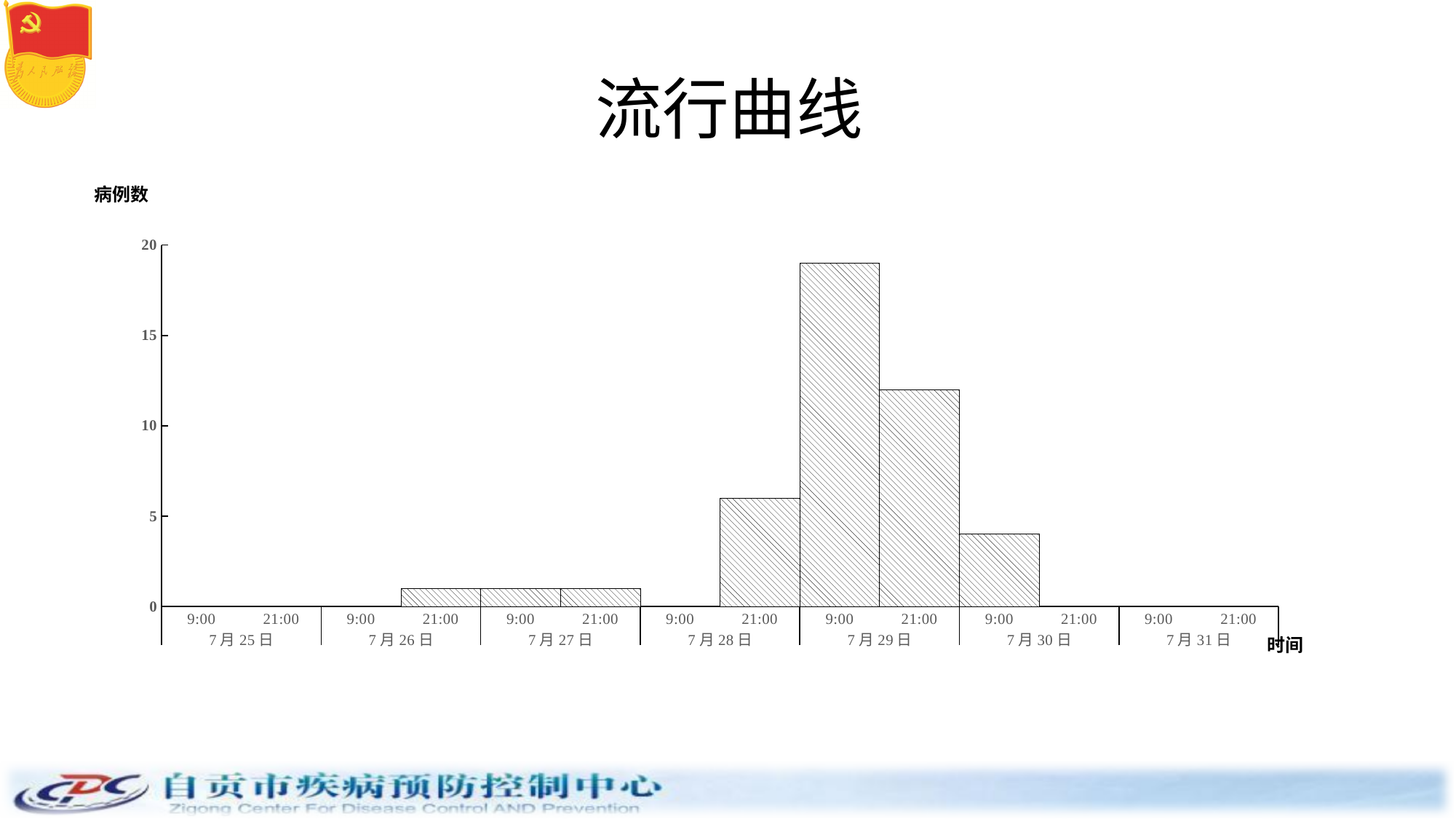
Which time slot has the highest number of cases? 7月29日 9:00 Is the value for 7月29日 21:00 greater or less than 10? greater Do the values rise or fall from 7月29日 9:00 to 7月30日 9:00? fall Is the value for 7月30日 9:00 greater or less than 5? less How many dates are shown along the x axis? 7 Is the value for 7月29日 9:00 greater or less than 15? greater Which is larger, the value for 7月28日 21:00 or the value for 7月30日 9:00? 7月28日 21:00 What is the title of the chart? 流行曲线 Which is larger, the value for 7月29日 9:00 or the value for 7月29日 21:00? 7月29日 9:00 What is the label on the vertical axis of the chart? 病例数 What kind of chart is shown on the slide? bar chart